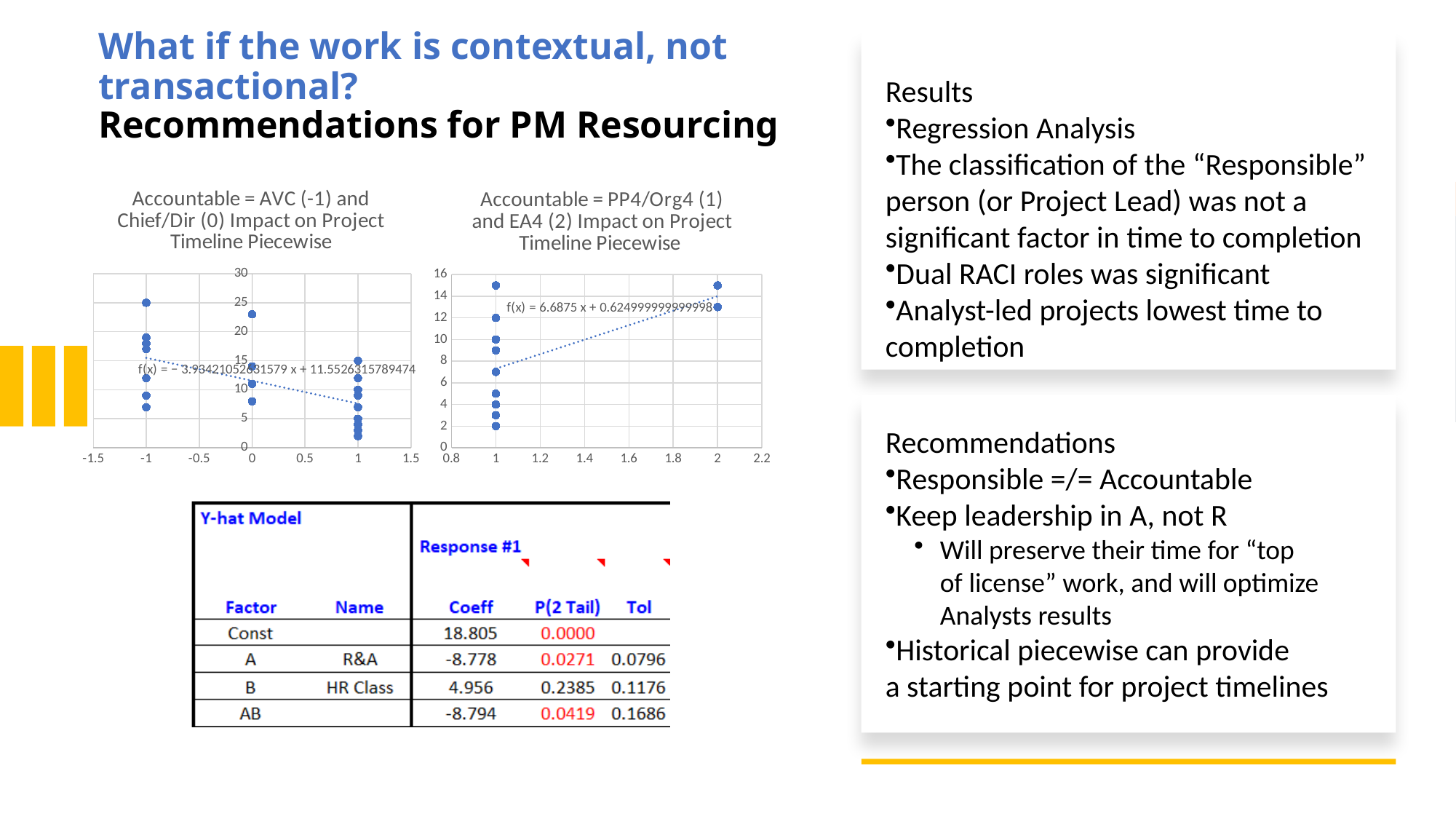
In the left chart (Accountable = AVC (-1) and Chief/Dir (0)), is the highest data point at x = 1 greater or less than 20? less In the left chart (Accountable = AVC (-1) and Chief/Dir (0)), does the dotted trendline rise or fall as x increases? Falls In the right chart (Accountable = PP4/Org4 (1) and EA4 (2)), does the dotted trendline rise or fall as x increases? Rises What kind of chart is the right chart titled "Accountable = PP4/Org4 (1) and EA4 (2) Impact on Project Timeline Piecewise"? Scatter chart What is the trendline equation shown on the right chart (Accountable = PP4/Org4 (1) and EA4 (2))? f(x) = 6.6875 x + 0.624999999999998 In the left chart (Accountable = AVC (-1) and Chief/Dir (0)), is the highest data point at x = -1 greater or less than 20? greater In the left chart (Accountable = AVC (-1) and Chief/Dir (0)), how many distinct x positions have data points plotted? 3 In the right chart (Accountable = PP4/Org4 (1) and EA4 (2)), how many distinct x positions have data points plotted? 2 What is the maximum value shown on the y axis of the right chart (Accountable = PP4/Org4 (1) and EA4 (2))? 16 What kind of chart is the left chart titled "Accountable = AVC (-1) and Chief/Dir (0) Impact on Project Timeline Piecewise"? Scatter chart In the right chart (Accountable = PP4/Org4 (1) and EA4 (2)), is the lowest data point at x = 1 greater or less than 4? less